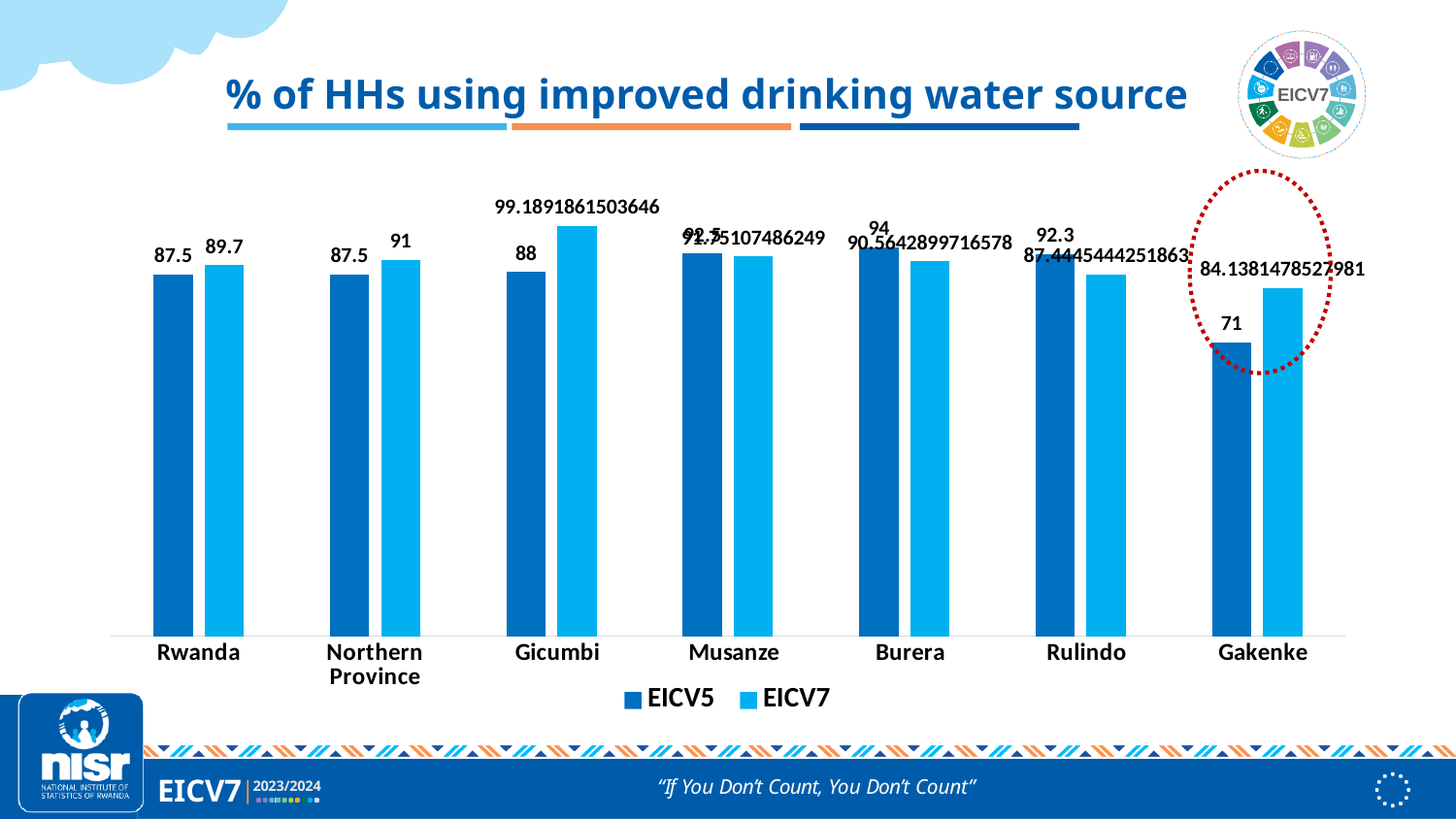
How many series does the legend list? 2 Which category has the lowest EICV5 value? Gakenke What is the EICV7 value for Gicumbi? 99.1891861503646 For Burera, which series has the larger value, EICV5 or EICV7? EICV5 How many categories are shown along the x axis of the chart? 7 What is the EICV5 value for Rulindo? 92.3 What is the EICV7 value for Rwanda? 89.7 What is the difference between the EICV7 and EICV5 values for Northern Province? 3.5 Which category has the highest EICV7 value? Gicumbi What is the EICV5 value for Gakenke? 71 What are the two series named in the legend? EICV5 and EICV7 What kind of chart is shown on the slide? bar chart